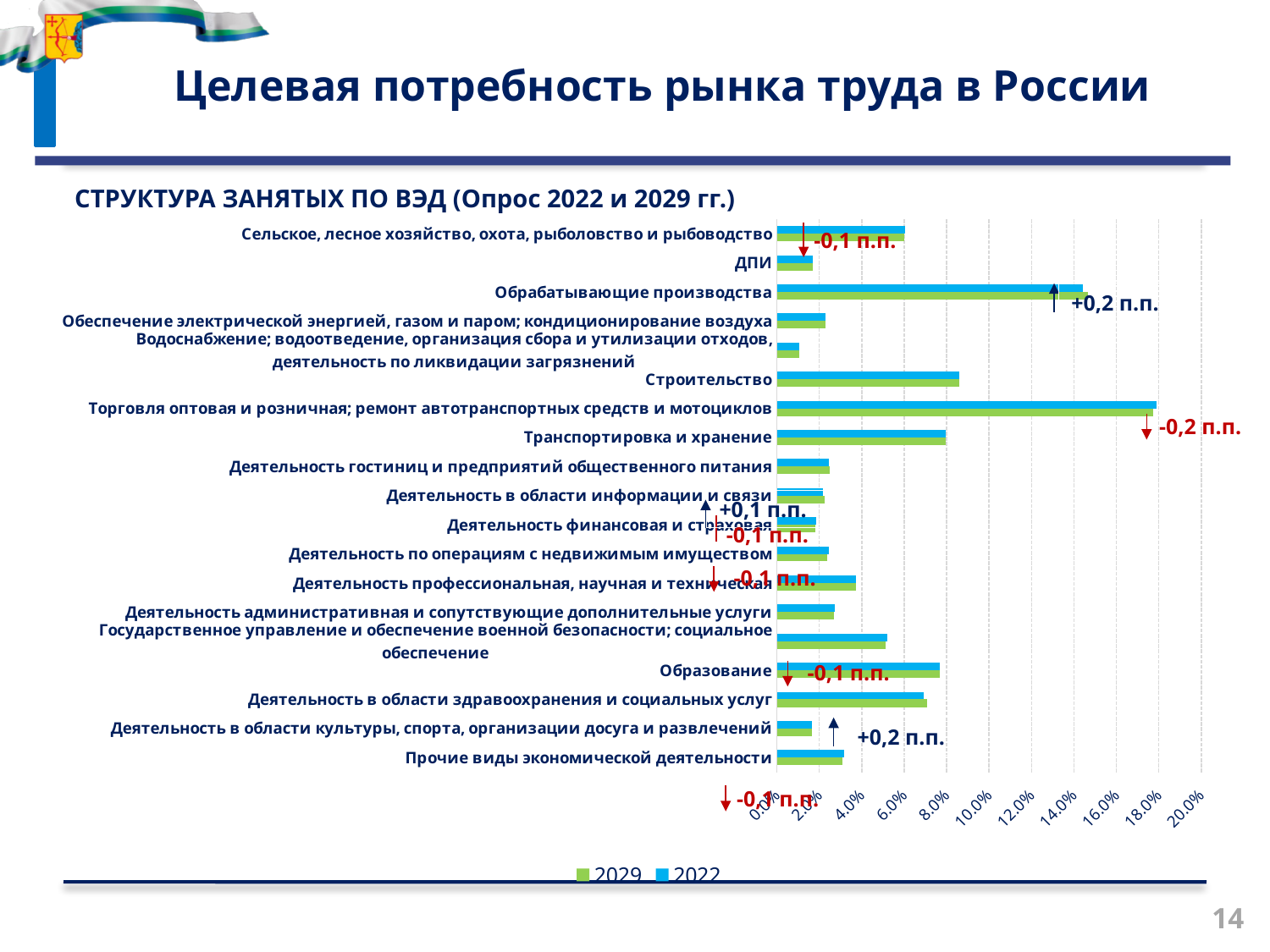
Which has the larger value: Строительство or ДПИ? Строительство How many categories (types of economic activity) are shown on the chart? 19 Is the 2022 value for Обрабатывающие производства greater or less than 12.0%? greater Which category has the lowest value in the chart? Водоснабжение; водоотведение, организация сбора и утилизации отходов, деятельность по ликвидации загрязнений Is the 2022 value for Торговля оптовая и розничная; ремонт автотранспортных средств и мотоциклов greater or less than 16.0%? greater Which two series are listed in the chart legend? 2029 and 2022 How many series does the chart legend list? 2 Is the 2022 value for Строительство greater or less than 10.0%? less What is the title of the chart? СТРУКТУРА ЗАНЯТЫХ ПО ВЭД (Опрос 2022 и 2029 гг.) Which category has the highest value in the chart? Торговля оптовая и розничная; ремонт автотранспортных средств и мотоциклов What kind of chart is shown on the slide? bar chart